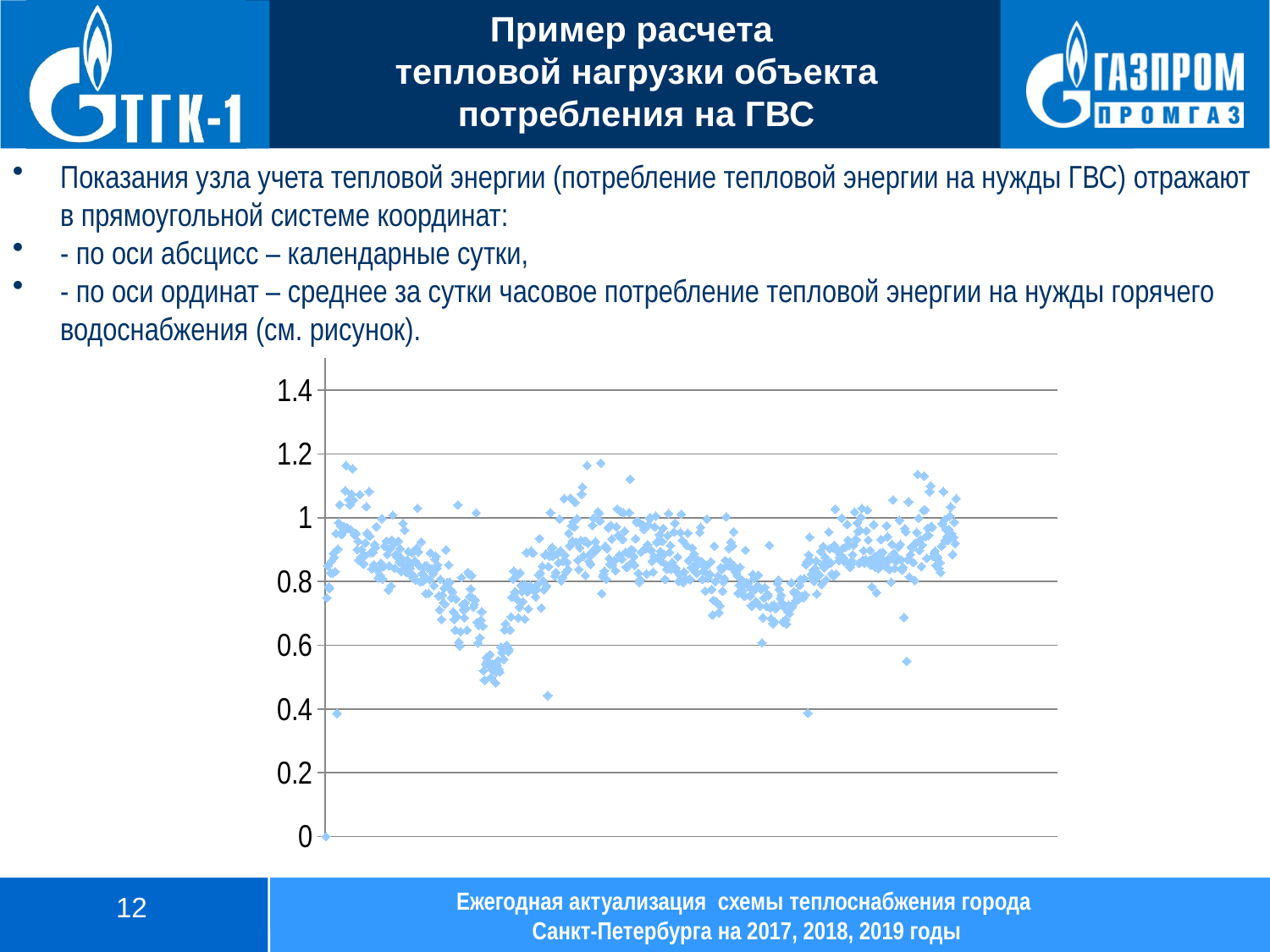
What kind of chart is shown on the slide? scatter chart Are the majority of the plotted points on the chart greater or less than 1.2? less Does the chart show a legend? No What is the interval between consecutive tick labels on the vertical axis of the chart? 0.2 Are the majority of the plotted points on the chart greater or less than 0.6? greater What is the highest value labelled on the vertical axis of the chart? 1.4 Is the highest plotted point on the chart greater or less than 1.4? less